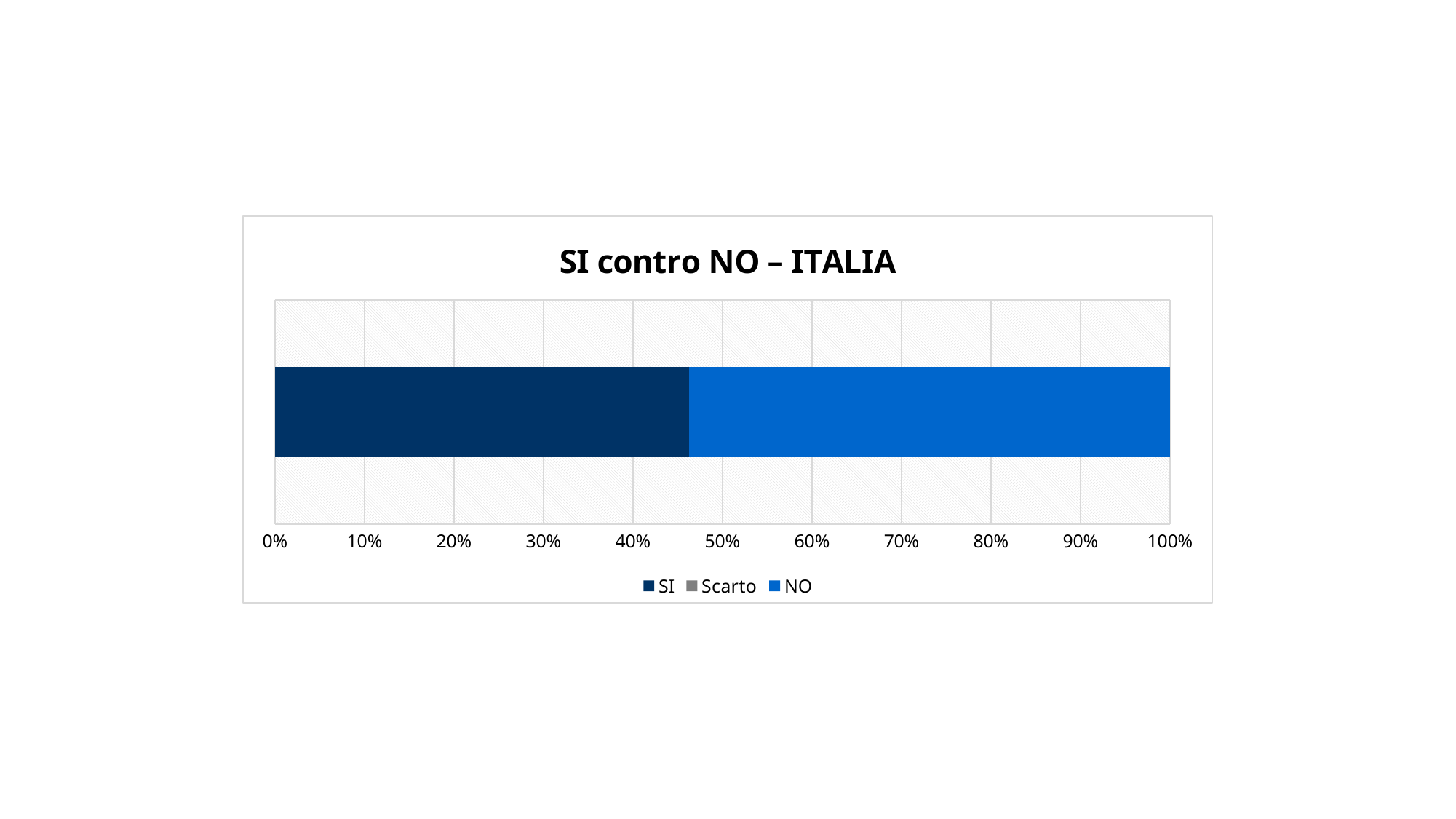
Is the value for SI greater or less than 50%? less What is the highest value shown on the horizontal axis? 100% Which series are listed in the legend? SI, Scarto, NO How many series does the legend list? 3 Is the value for SI greater or less than 40%? greater How many bars are plotted in the chart? 1 What is the title of the chart? SI contro NO – ITALIA Which is larger, the SI share or the NO share? NO Is the value for NO greater or less than 50%? greater What kind of chart is shown on the slide? bar chart